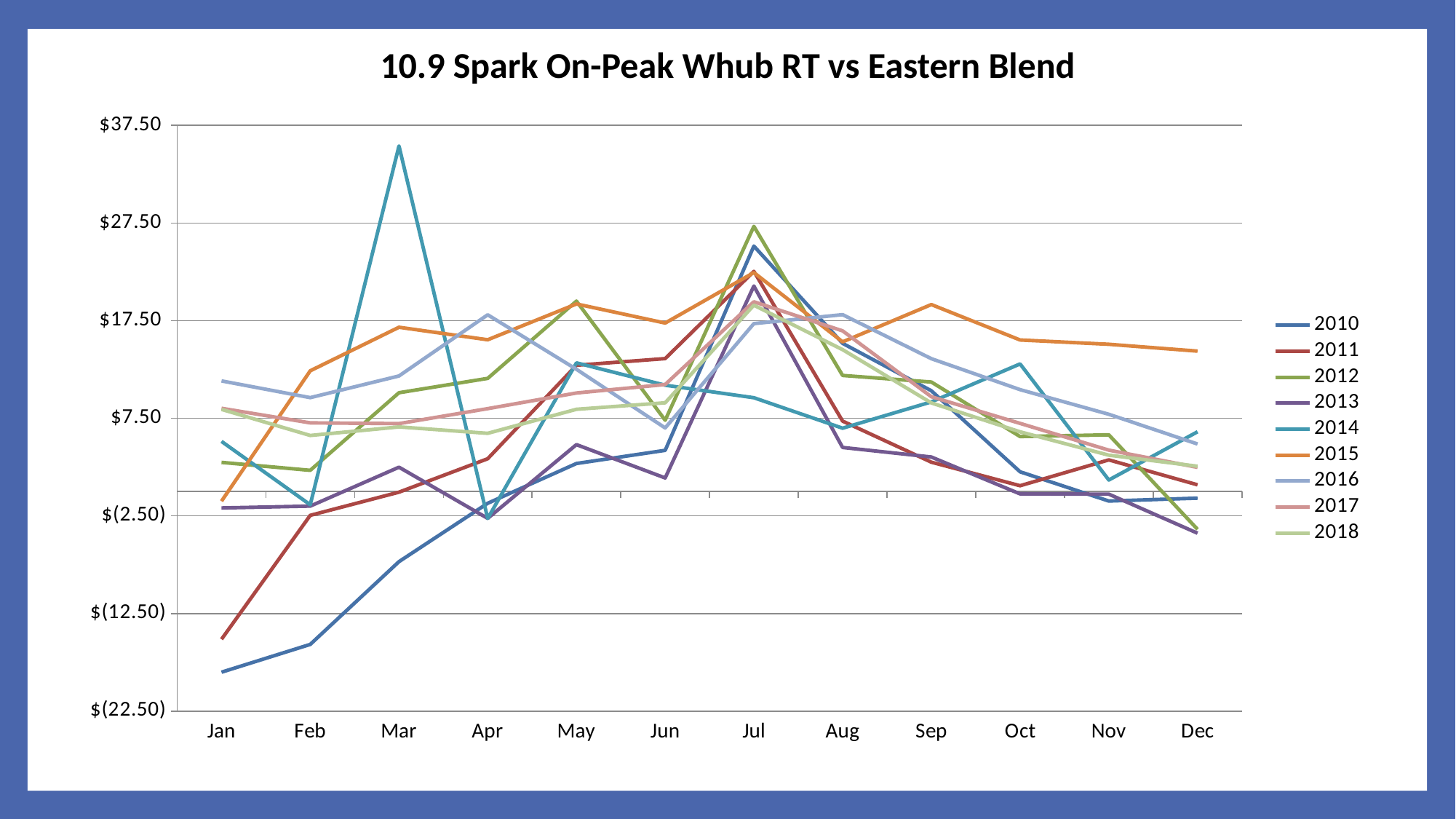
Is the value for 2015 in Dec greater or less than $7.50? greater What is the title of the chart? 10.9 Spark On-Peak Whub RT vs Eastern Blend Is the value for 2014 in Mar greater or less than $27.50? greater Which series has the highest value in Jul? 2012 Which is larger: the value for 2014 in Mar or the value for 2012 in Jul? 2014 in Mar Is the value for 2010 in Jan greater or less than $(12.50)? less What kind of chart is shown on the slide? line chart How many series does the legend list? 9 How many months are shown along the x axis? 12 In which month does the 2014 series reach its highest value? Mar In which month does the 2010 series have its lowest value? Jan